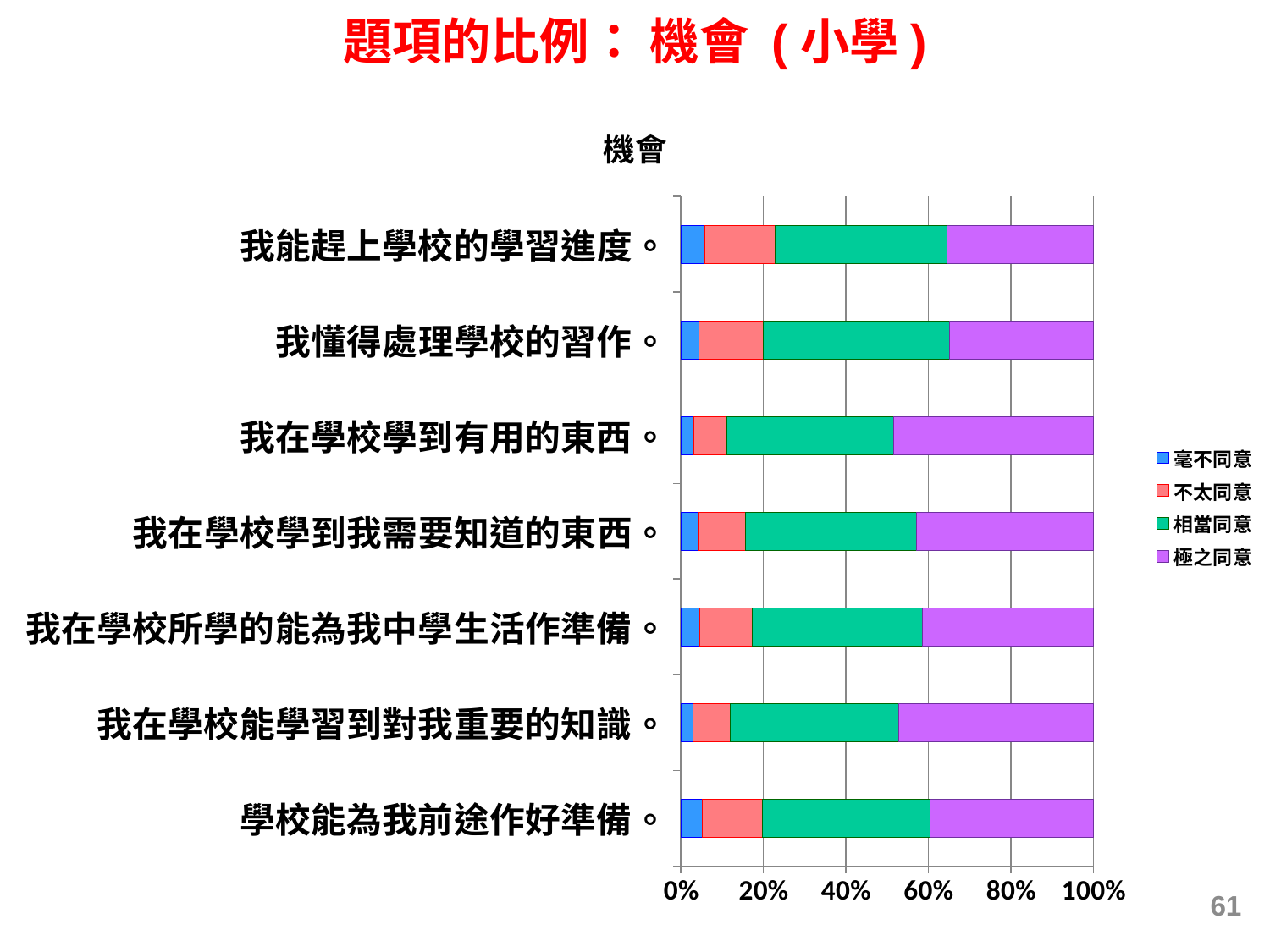
How many statements (categories) are plotted in the chart? 7 Which legend entry is shown in purple? 極之同意 What kind of chart is shown on the slide? stacked bar chart Which has the larger 不太同意 share: 我能趕上學校的學習進度 or 我在學校學到有用的東西? 我能趕上學校的學習進度 Is the 毫不同意 share for 我能趕上學校的學習進度 greater or less than 20%? less Is the 相當同意 share for 學校能為我前途作好準備 greater or less than 20%? greater Is the 極之同意 share for 我在學校學到有用的東西 greater or less than 40%? greater What is the title of the chart? 機會 Which has the larger 極之同意 share: 我在學校學到有用的東西 or 我能趕上學校的學習進度? 我在學校學到有用的東西 What does each stacked bar total on the x axis? 100% How many series does the legend list? 4